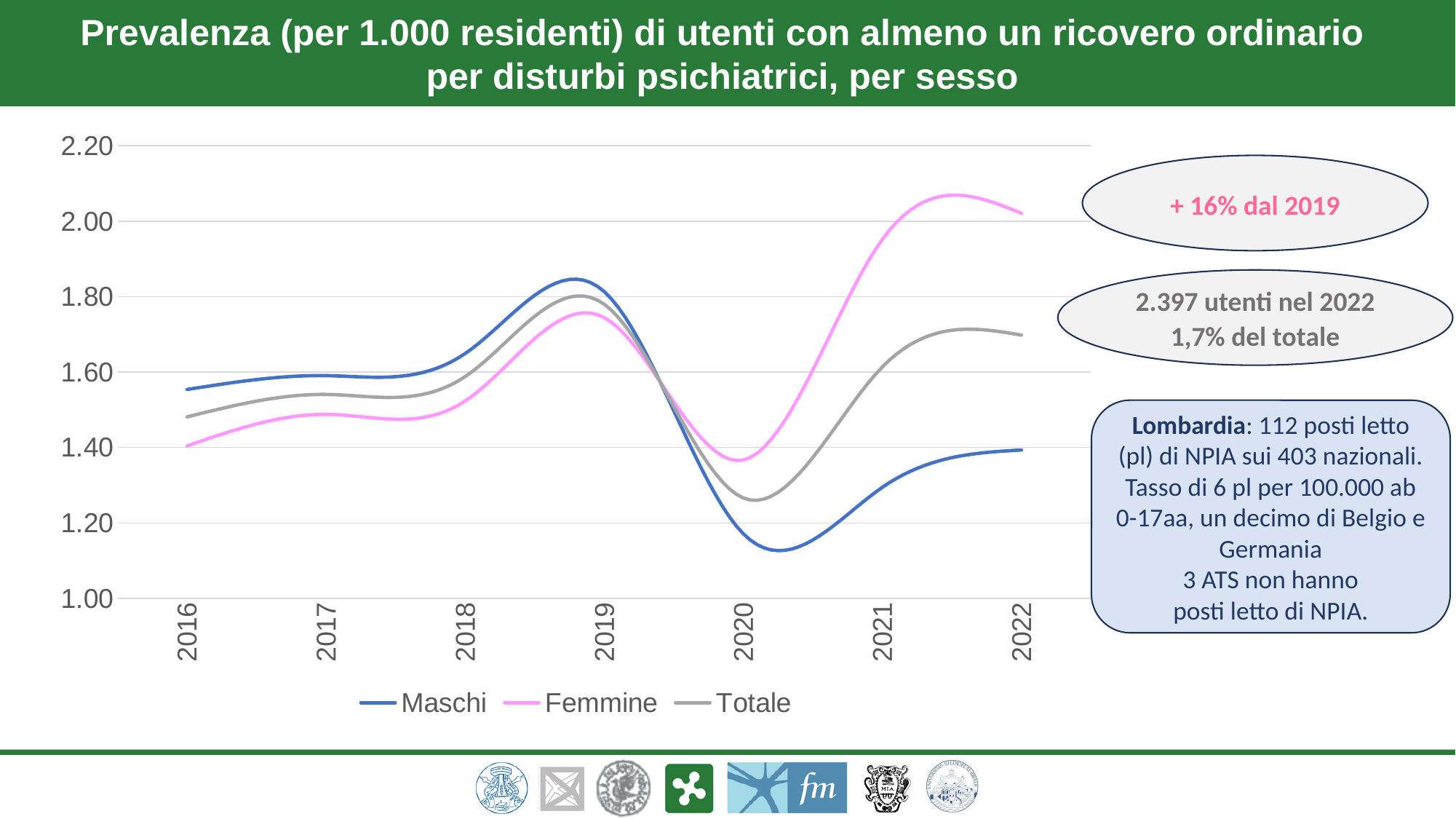
In which year is the Totale series at its lowest? 2020 What kind of chart is shown on the slide? Line chart In 2022, which series has the higher value, Maschi or Femmine? Femmine In 2016, which series has the higher value, Maschi or Femmine? Maschi Is the value for Maschi in 2020 greater or less than 1.20? less Is the value for Totale in 2022 greater or less than 1.60? greater Does the Femmine series rise or fall between 2020 and 2022? Rise How many series does the legend list? 3 In which year is the Maschi series at its lowest? 2020 How many years are shown on the x axis? 7 Is the value for Femmine in 2016 greater or less than 1.60? less In which year is the Maschi series at its highest? 2019